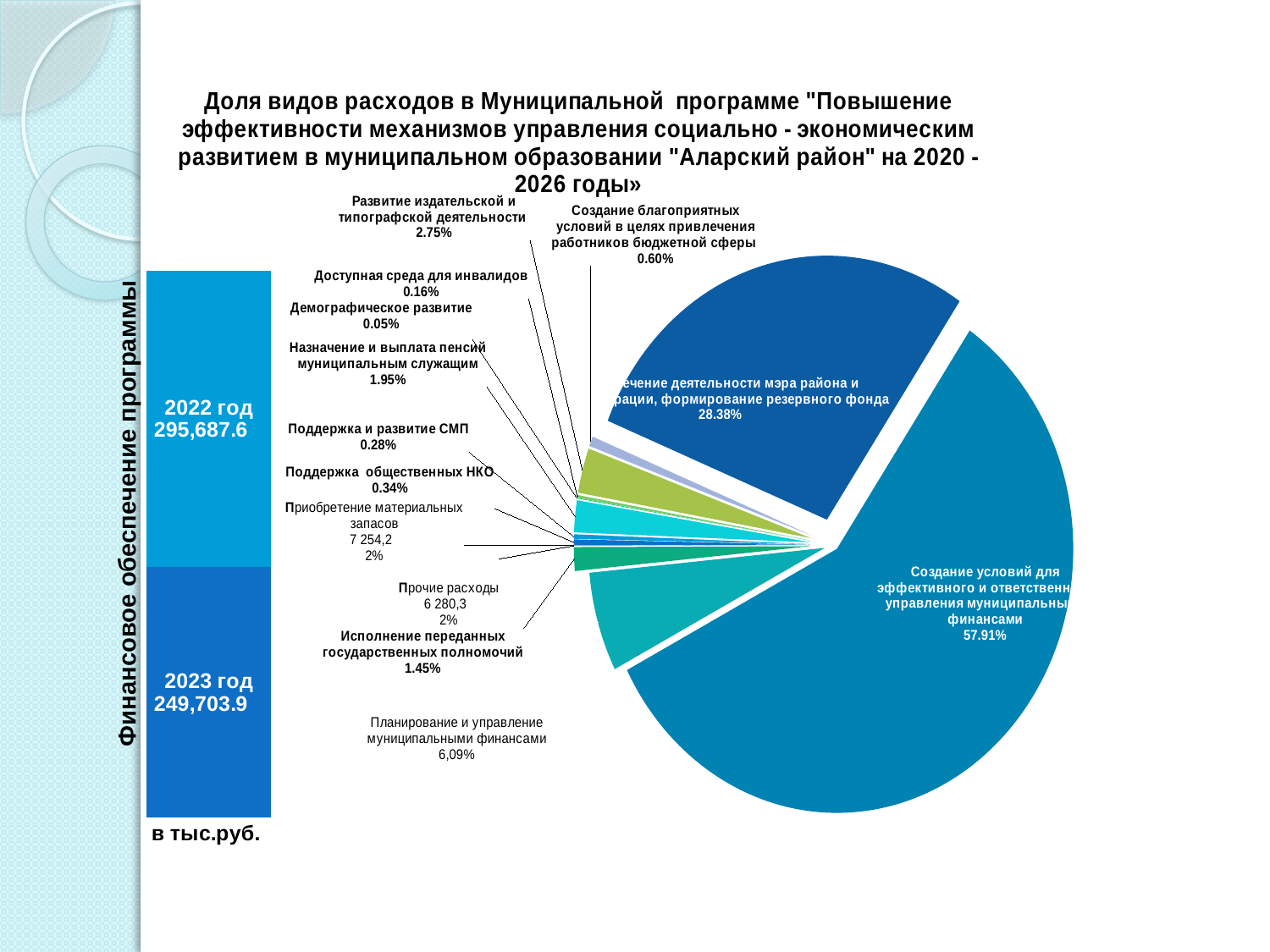
Which year has the larger value in the bar on the left: 2022 год or 2023 год? 2022 год What percentage is shown for "Планирование и управление муниципальными финансами"? 6,09% What is the difference in percentage points between the 57.91% slice and the 28.38% slice? 29.53% What share of the pie does "Создание условий для эффективного и ответственного управления муниципальными финансами" have? 57.91% Which is larger: the share for "Поддержка общественных НКО" or for "Поддержка и развитие СМП"? Поддержка общественных НКО What is the value shown for "2022 год" in the bar on the left of the slide? 295,687.6 What percentage is shown for "Назначение и выплата пенсий муниципальным служащим"? 1.95% How many slices does the pie chart have? 13 What percentage is shown for "Развитие издательской и типографской деятельности"? 2.75% Which category has the largest share of the pie? Создание условий для эффективного и ответственного управления муниципальными финансами What kind of chart is shown on the slide? pie chart